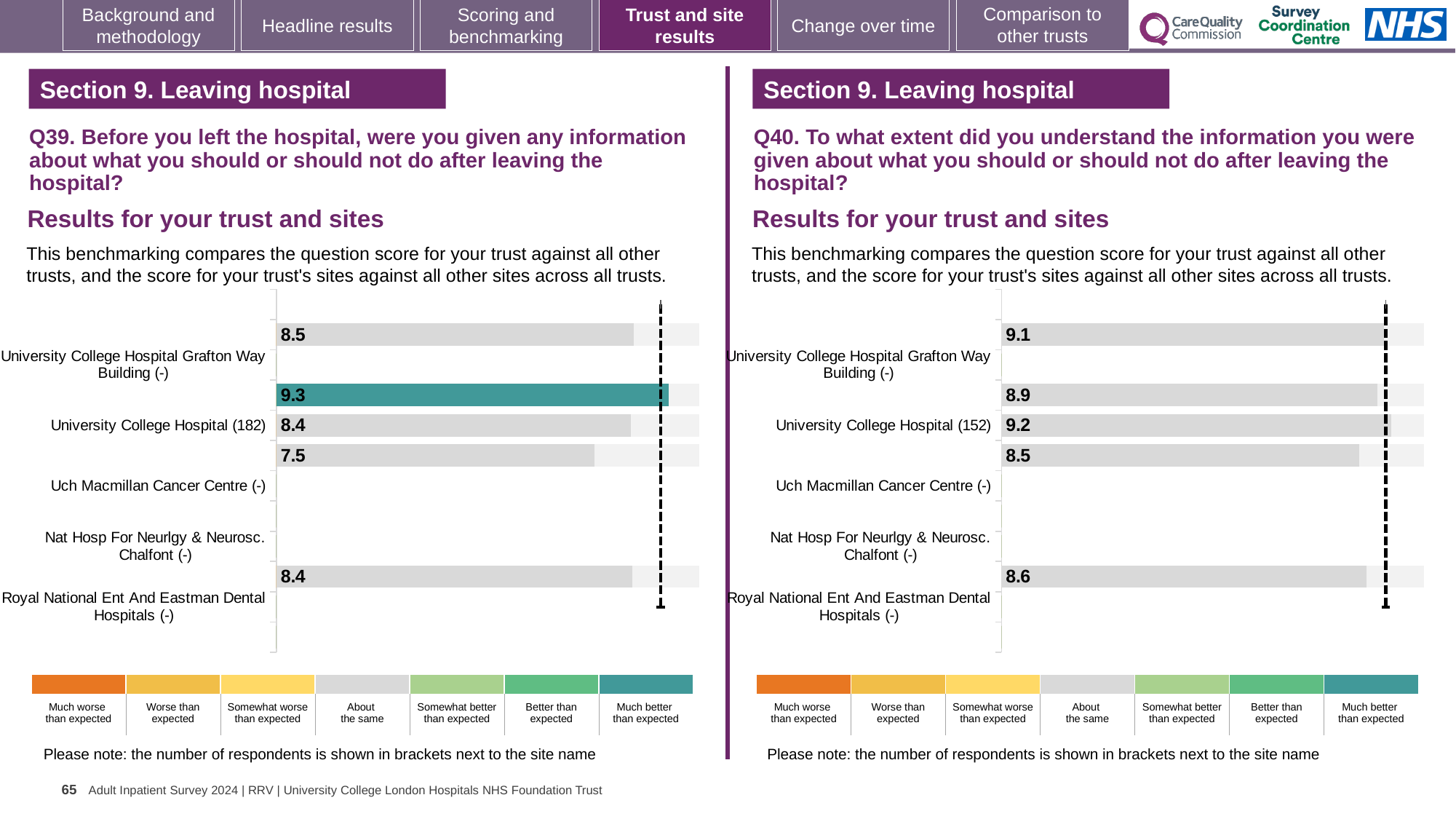
On the left (Q39) chart, what is the score shown for University College Hospital (182)? 8.4 On the left (Q39) chart, what is the highest score printed on any bar? 9.3 How many site names are listed on the left (Q39) chart's vertical axis? 5 How many categories does the colour key below the left (Q39) chart list? 7 What kind of chart is used on the left (Q39) chart? bar chart On the right (Q40) chart, what is the score shown for University College Hospital (152)? 9.2 Is the score for University College Hospital higher on the left (Q39) chart or on the right (Q40) chart? right (Q40) chart On the right (Q40) chart, what is the highest score printed on any bar? 9.2 On the left (Q39) chart, what is the difference between the highest printed score (9.3) and the lowest printed score (7.5)? 1.8 On the left (Q39) chart, what is the lowest score printed on any bar? 7.5 On the right (Q40) chart, what is the lowest score printed on any bar? 8.5 On the right (Q40) chart, what is the difference between the highest printed score (9.2) and the lowest printed score (8.5)? 0.7